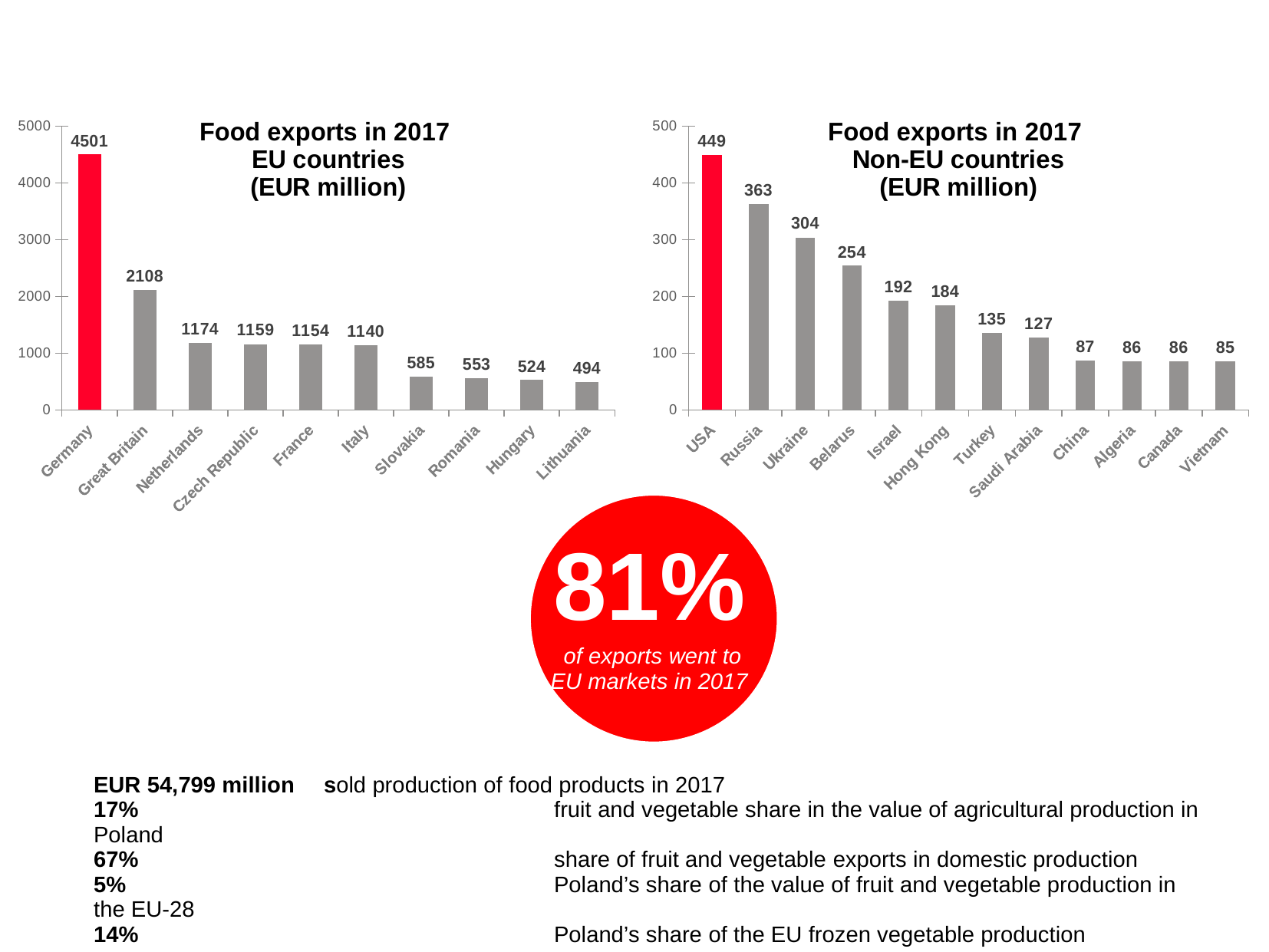
What kind of chart is the 'Food exports in 2017 Non-EU countries' chart? bar chart In the 'Food exports in 2017 EU countries' chart, which country has the lowest value? Lithuania In the 'Food exports in 2017 EU countries' chart, which bar is coloured red? Germany In the 'Food exports in 2017 EU countries' chart, what is the value for Germany? 4501 In the 'Food exports in 2017 Non-EU countries' chart, which country has the highest value? USA In the 'Food exports in 2017 EU countries' chart, which is larger, Slovakia or Romania? Slovakia In the 'Food exports in 2017 EU countries' chart, how many countries are shown? 10 In the 'Food exports in 2017 Non-EU countries' chart, what is the difference between Russia and Belarus? 109 In the 'Food exports in 2017 EU countries' chart, what is the difference between Germany and Great Britain? 2393 In the 'Food exports in 2017 Non-EU countries' chart, do the values rise or fall from left to right? fall In the 'Food exports in 2017 Non-EU countries' chart, what is the value for Ukraine? 304 In the 'Food exports in 2017 Non-EU countries' chart, how many countries are shown? 12